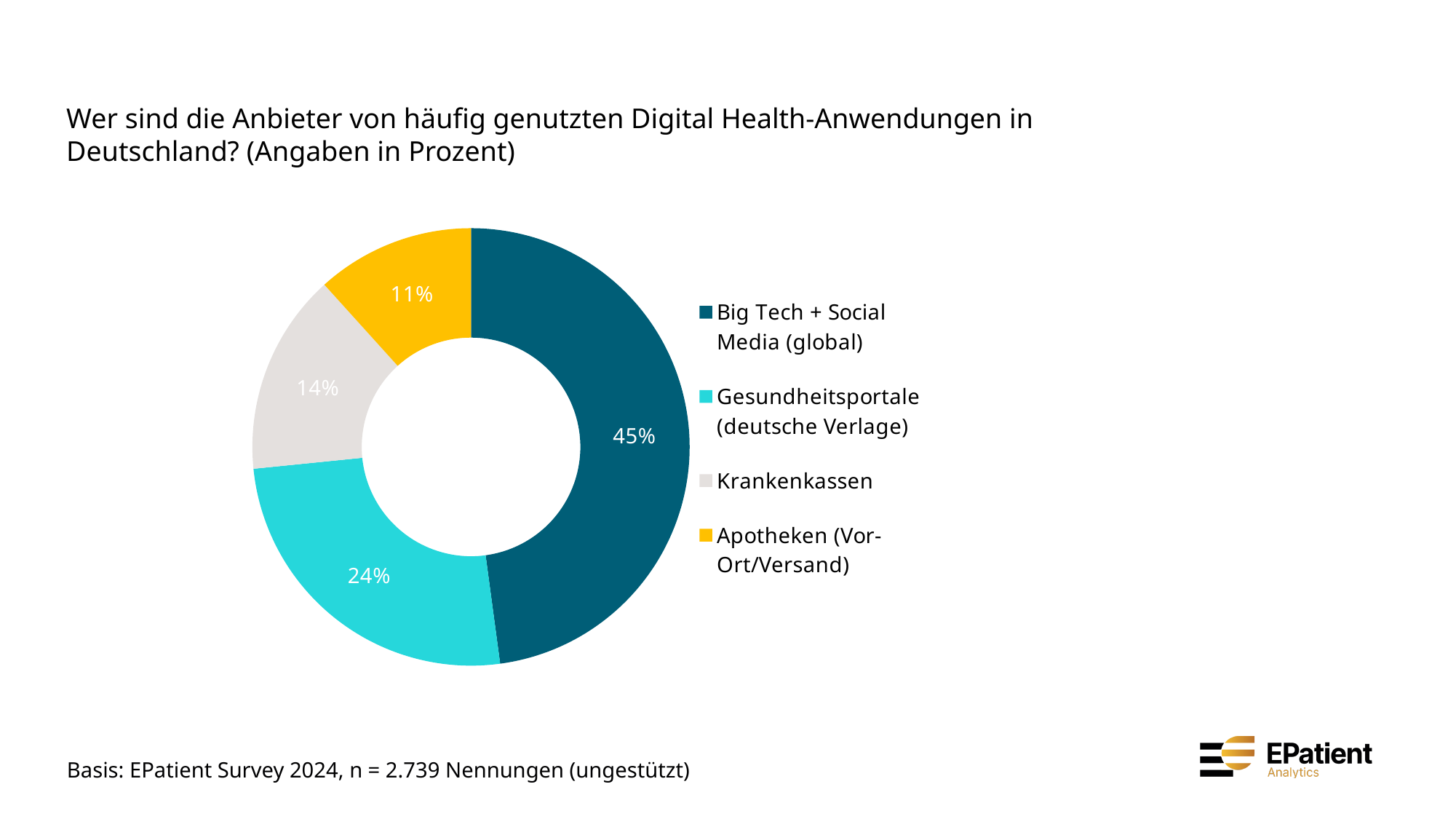
What share of the pie does Apotheken (Vor-Ort/Versand) hold? 11% What share of the pie does Big Tech + Social Media (global) hold? 45% What share of the pie does Gesundheitsportale (deutsche Verlage) hold? 24% Which category has the largest slice? Big Tech + Social Media (global) What is the difference in percentage points between Big Tech + Social Media (global) and Gesundheitsportale (deutsche Verlage)? 21 What is the difference in percentage points between Krankenkassen and Apotheken (Vor-Ort/Versand)? 3 Which category has the smallest slice? Apotheken (Vor-Ort/Versand) How many categories does the chart show? 4 What share of the pie does Krankenkassen hold? 14% Which is larger, the slice for Gesundheitsportale (deutsche Verlage) or the slice for Krankenkassen? Gesundheitsportale (deutsche Verlage) What kind of chart is shown on the slide? Pie chart (donut) What colour is the slice for Krankenkassen? Light grey